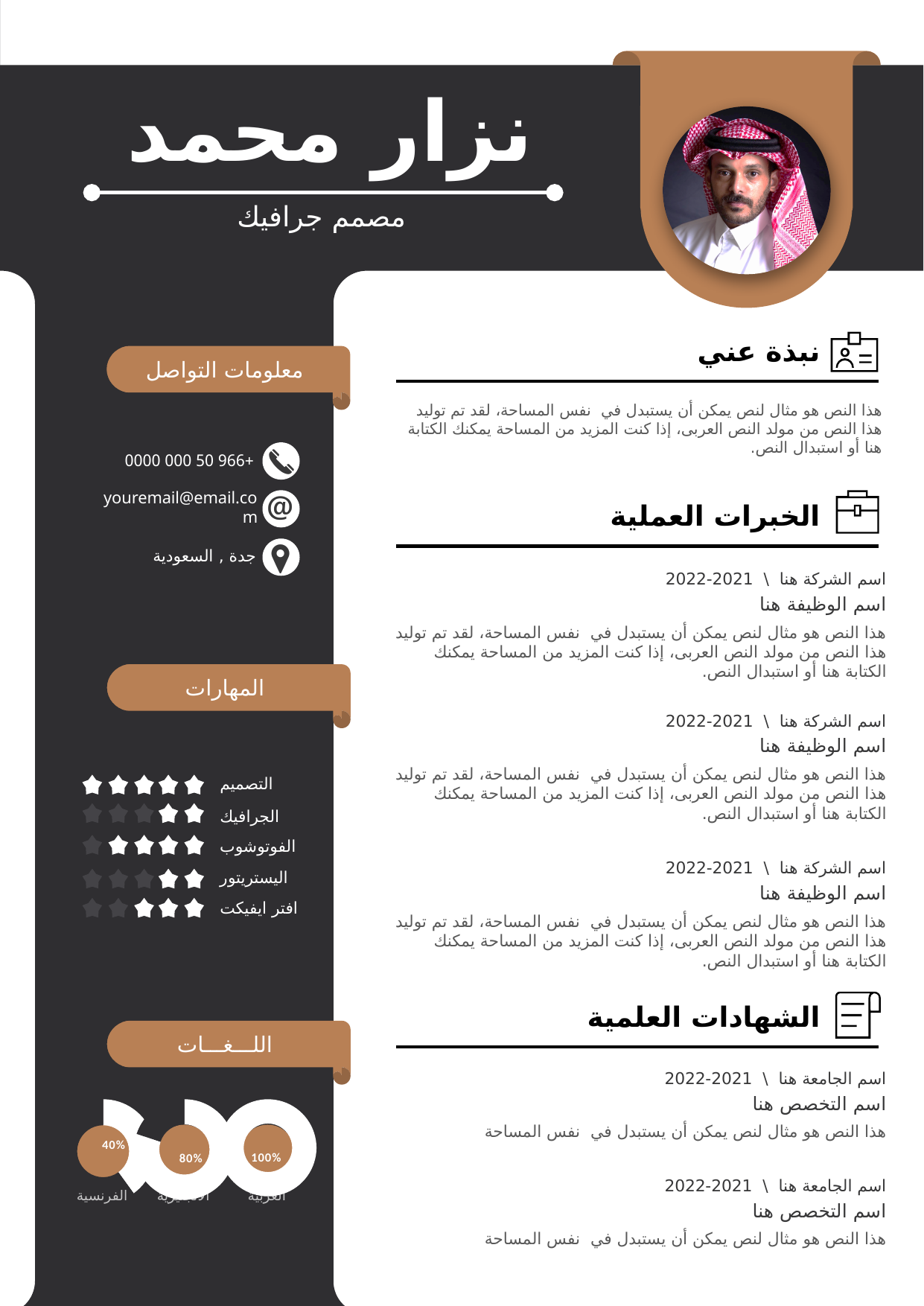
In the languages section (اللغات), what is the difference between the value for العربية and the value for الفرنسية? 60% In the languages section (اللغات), which language has the highest value? العربية What kind of chart is used in the languages section (اللغات)? Doughnut chart In the languages section (اللغات), what value is shown for العربية? 100% What is the title of the section containing the doughnut charts? اللغات In the languages section (اللغات), what value is shown in the middle doughnut chart? 80% How many doughnut charts are shown in the languages section (اللغات)? 3 In the languages section (اللغات), what is the difference between the middle chart's value and the value for الفرنسية? 40% In the languages section (اللغات), what value is shown for الفرنسية? 40% In the languages section (اللغات), which is larger: the value for العربية or the value for الفرنسية? العربية In the languages section (اللغات), which language has the lowest value? الفرنسية What colour is the filled centre circle of each doughnut chart in the languages section (اللغات)? Brown